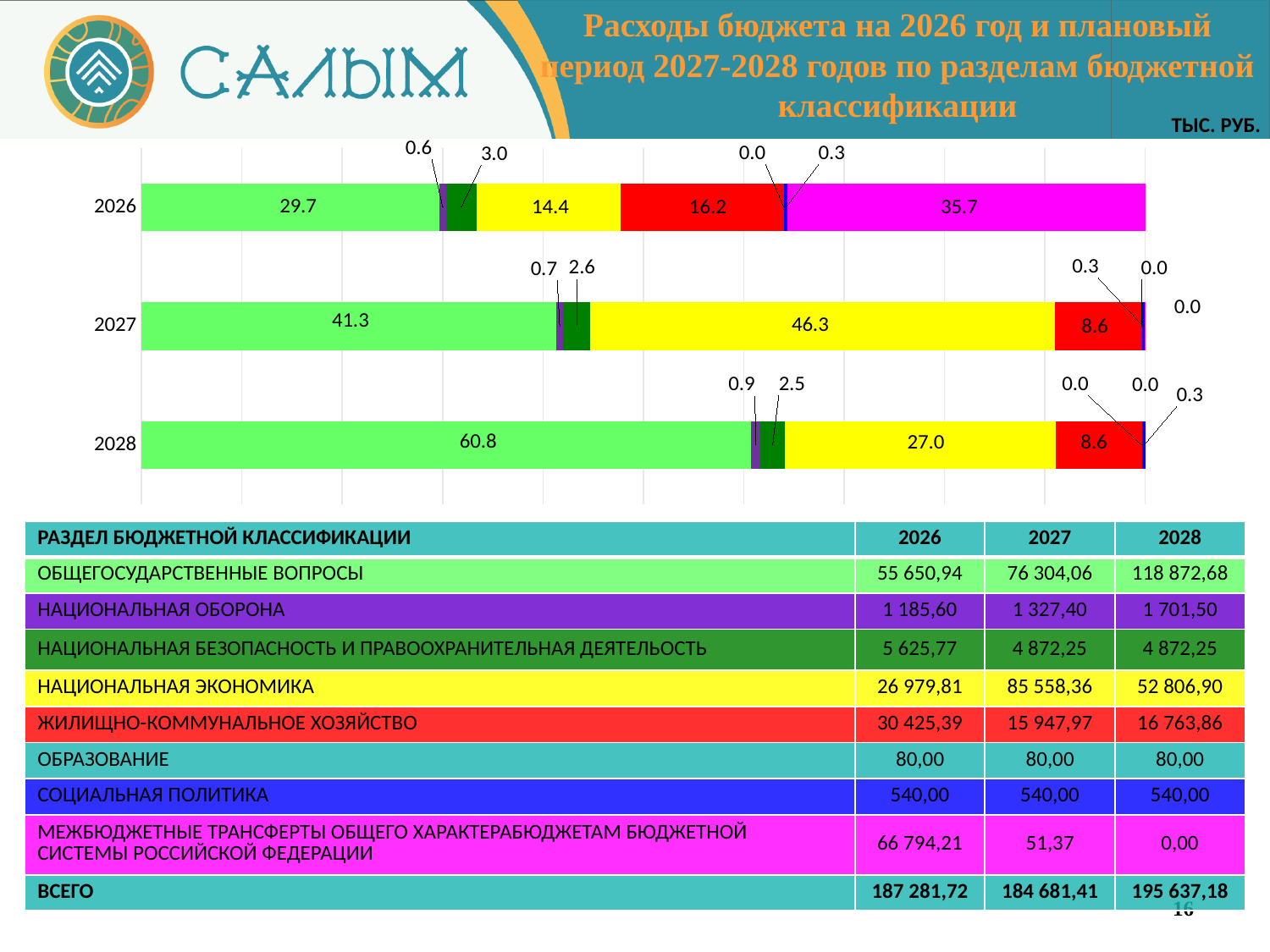
What is the value of the red segment (Жилищно-коммунальное хозяйство) in the 2028 bar? 8.6 Which segment is the largest in the 2028 bar? Light green (Общегосударственные вопросы), 60.8 What is the value of the magenta segment (Межбюджетные трансферты) in the 2026 bar? 35.7 Does the light green segment (Общегосударственные вопросы) rise or fall from 2026 to 2028? Rises What is the value of the yellow segment (Национальная экономика) in the 2027 bar? 46.3 What unit is indicated in the top right corner of the slide? ТЫС. РУБ. What is the value of the light green segment (Общегосударственные вопросы) in the 2026 bar? 29.7 What is the difference between the light green segment in 2028 (60.8) and in 2026 (29.7)? 31.1 What kind of chart is shown on the slide? Stacked bar chart Which segment is the largest in the 2026 bar? Magenta (Межбюджетные трансферты), 35.7 In the 2027 bar, which is larger: the light green segment or the yellow segment? Yellow (46.3) How many years (bars) does the chart show? 3